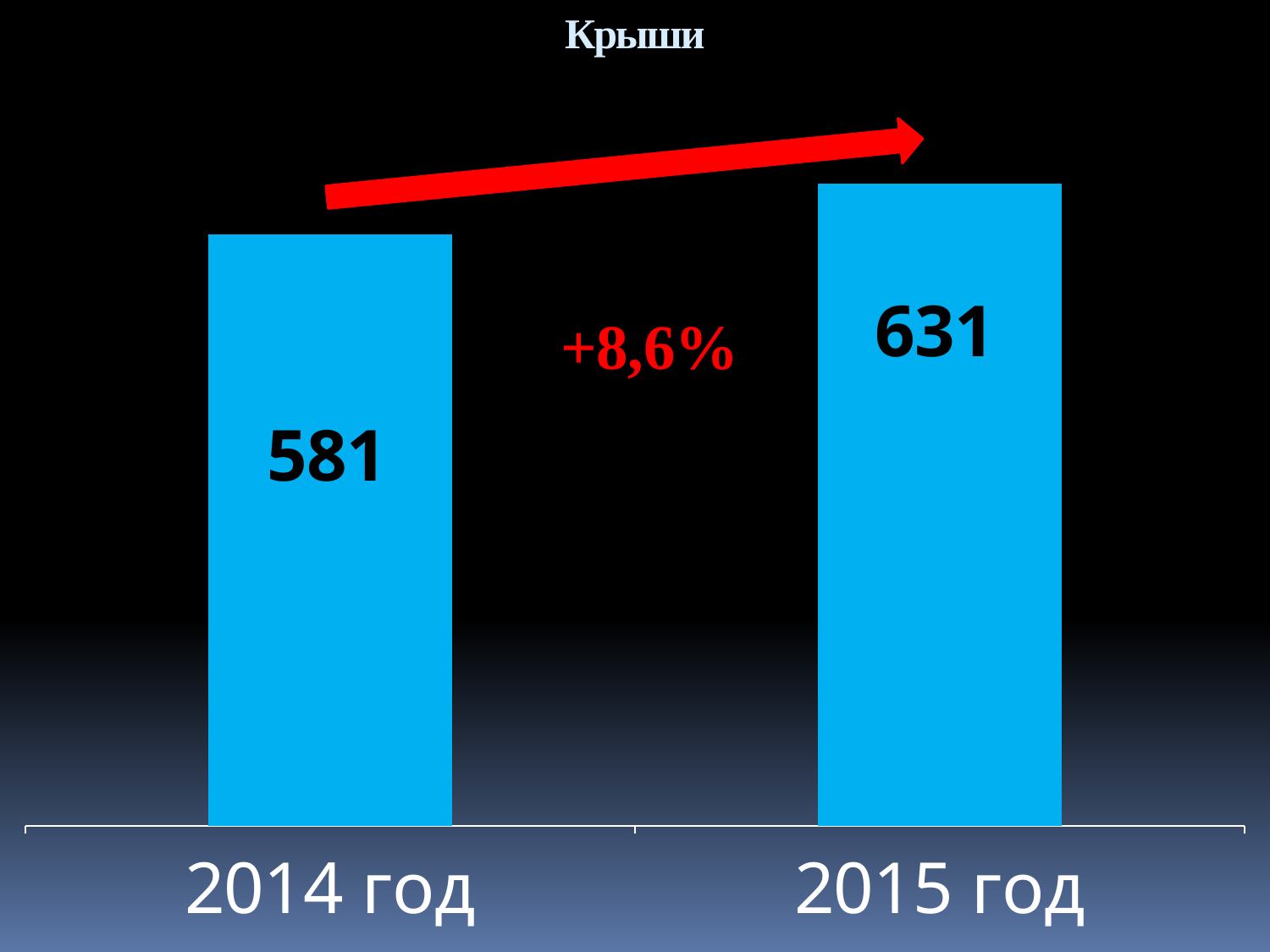
Which is larger, the value for 2014 год or the value for 2015 год? 2015 год What percentage change is printed between the two bars? +8,6% Which year has the highest value? 2015 год What is the title of the chart? Крыши Do the values rise or fall from 2014 год to 2015 год? Rise What is the value for 2014 год? 581 What is the difference between the values for 2015 год and 2014 год? 50 What kind of chart is shown on the slide? Bar chart Which year has the lowest value? 2014 год What is the value for 2015 год? 631 How many categories are shown in the chart? 2